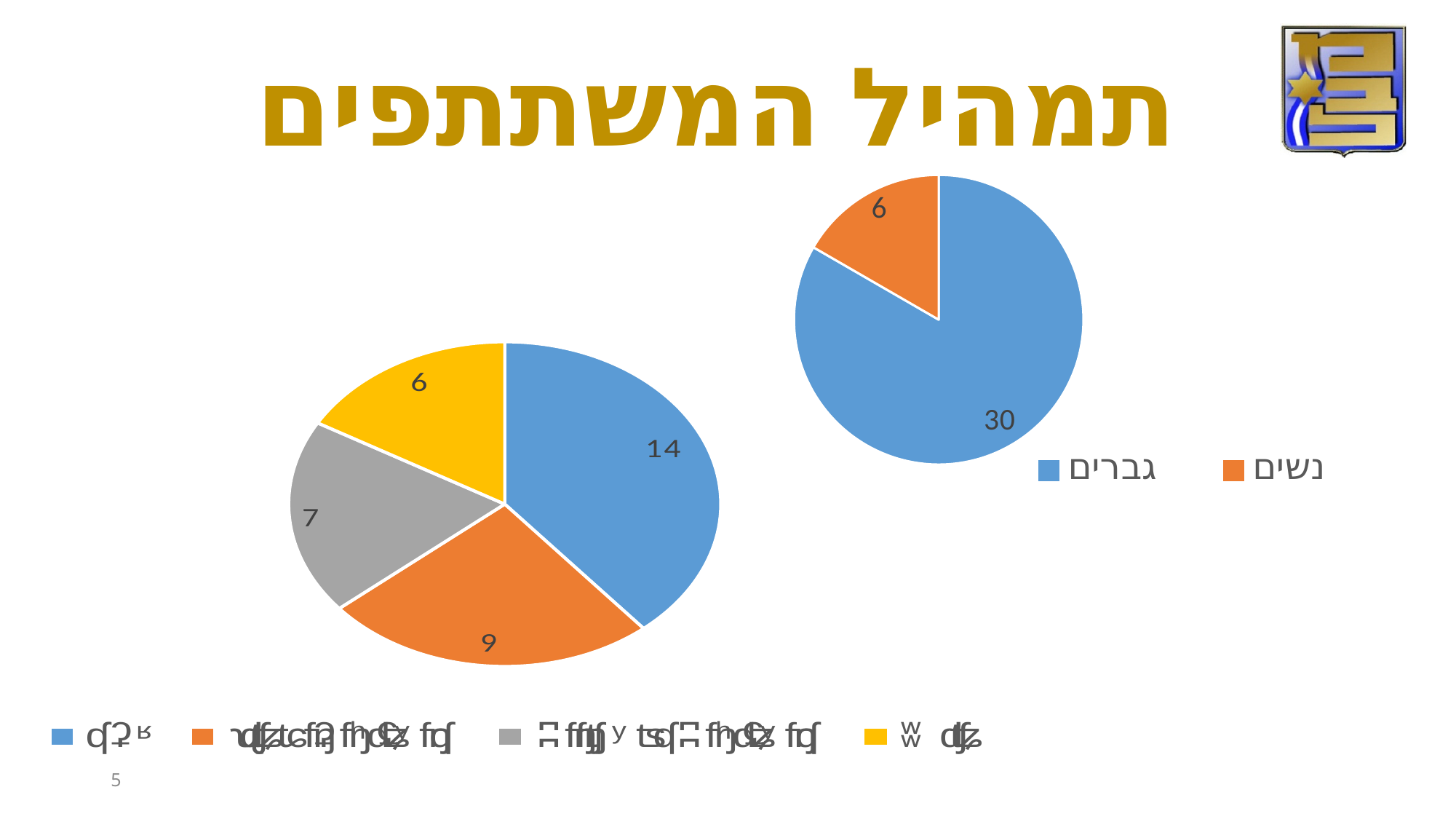
In the pie chart on the left, what is the total of all four slices? 36 What kind of chart is the chart on the left of the slide? Pie chart In the pie chart on the left, what is the value of the largest slice? 14 In the pie chart on the right, what is the difference between the values for גברים and נשים? 24 In the pie chart on the right, what is the total of the two slices? 36 In the pie chart on the left, what is the value of the smallest slice? 6 In the pie chart on the right, what is the value for גברים? 30 In the pie chart on the right, how many categories does the legend list? 2 In the pie chart on the right, which category has the largest slice? גברים In the pie chart on the left, how many slices are there? 4 What is the title of the slide? תמהיל המשתתפים In the pie chart on the right, what is the value for נשים? 6